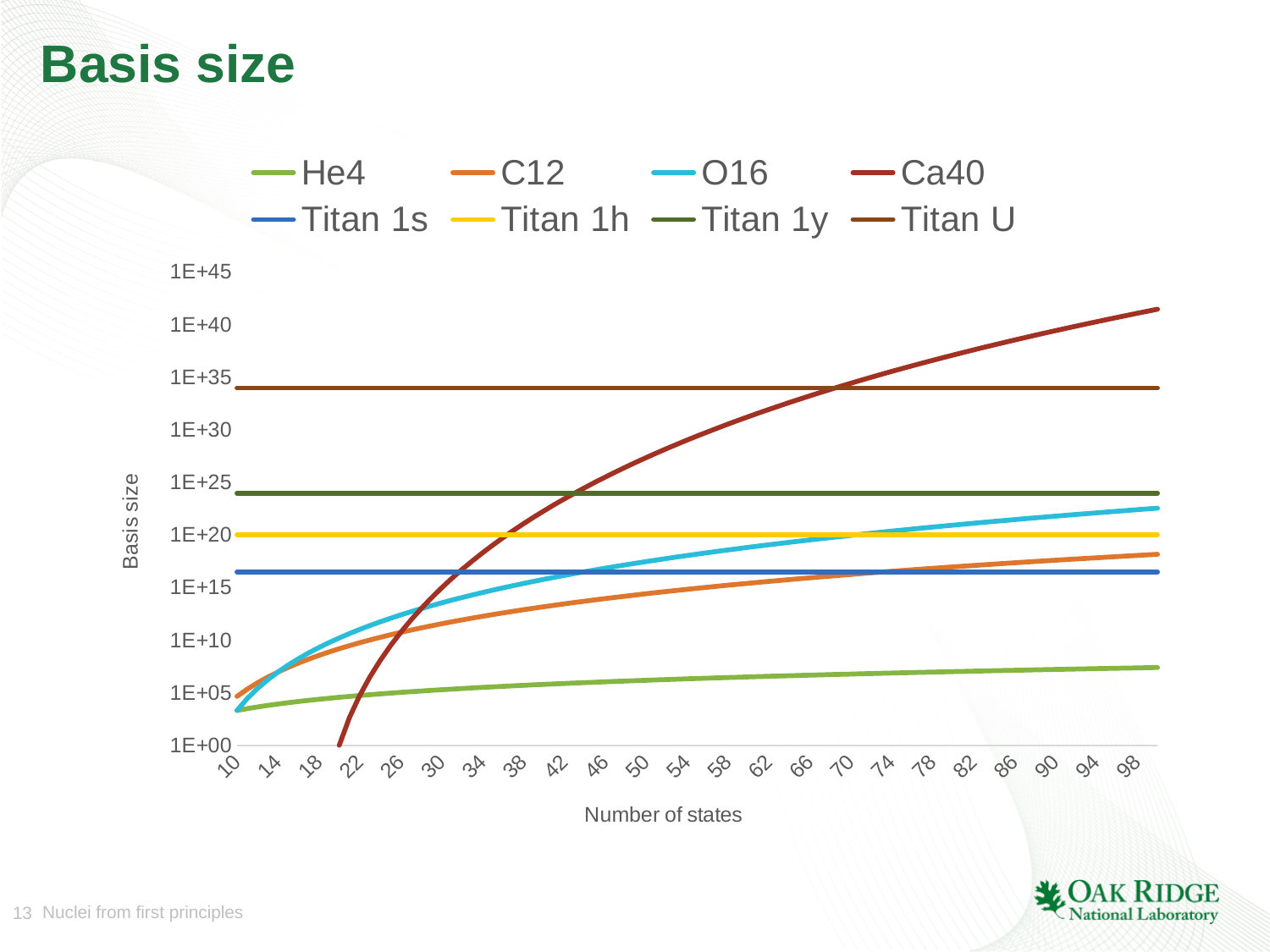
Does the basis size for Ca40 rise or fall as the number of states increases? rise How many series does the legend list? 8 Is the value of the Titan U line greater or less than 1E+30? greater Is the value of the Titan 1y line greater or less than 1E+20? greater At 98 states, which series has the larger basis size, O16 or C12? O16 Is the basis size for He4 at 98 states greater or less than 1E+10? less What is the title of the chart's y axis? Basis size Which series has the highest basis size at 98 states? Ca40 What kind of chart is shown on the slide? line chart Which series has the lowest basis size at 98 states? He4 What is the title of the chart's x axis? Number of states